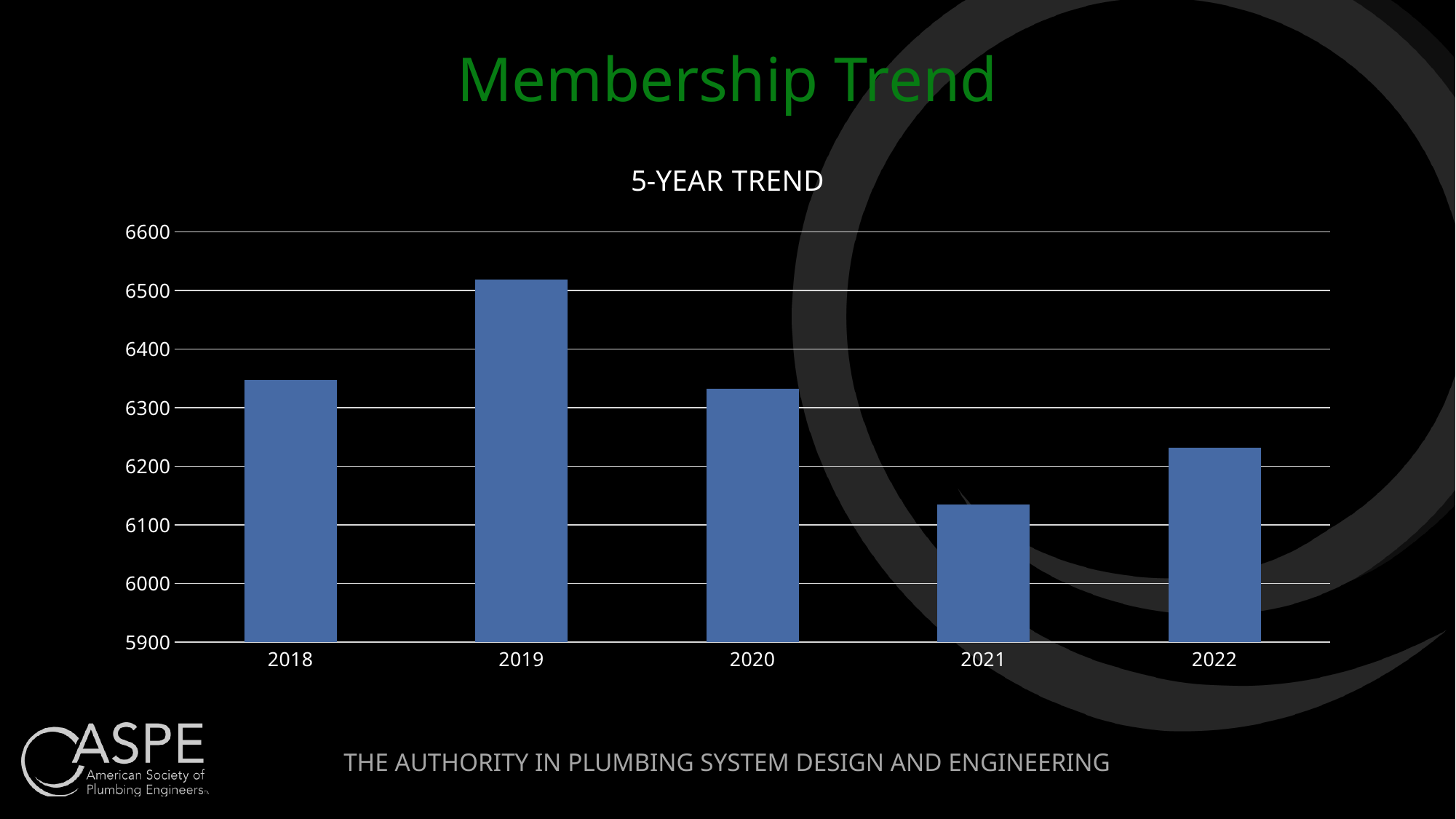
What is the title of the chart? 5-YEAR TREND Is the value for 2019 greater or less than 6500? greater Did the membership value rise or fall from 2019 to 2021? fall How many years are shown on the x axis of the chart? 5 Is the value for 2020 greater or less than 6400? less Which year has the lowest membership value? 2021 Which is larger, the value for 2019 or the value for 2022? 2019 Which year has the highest membership value? 2019 What type of chart is shown on the slide? bar chart Is the value for 2022 greater or less than 6200? greater